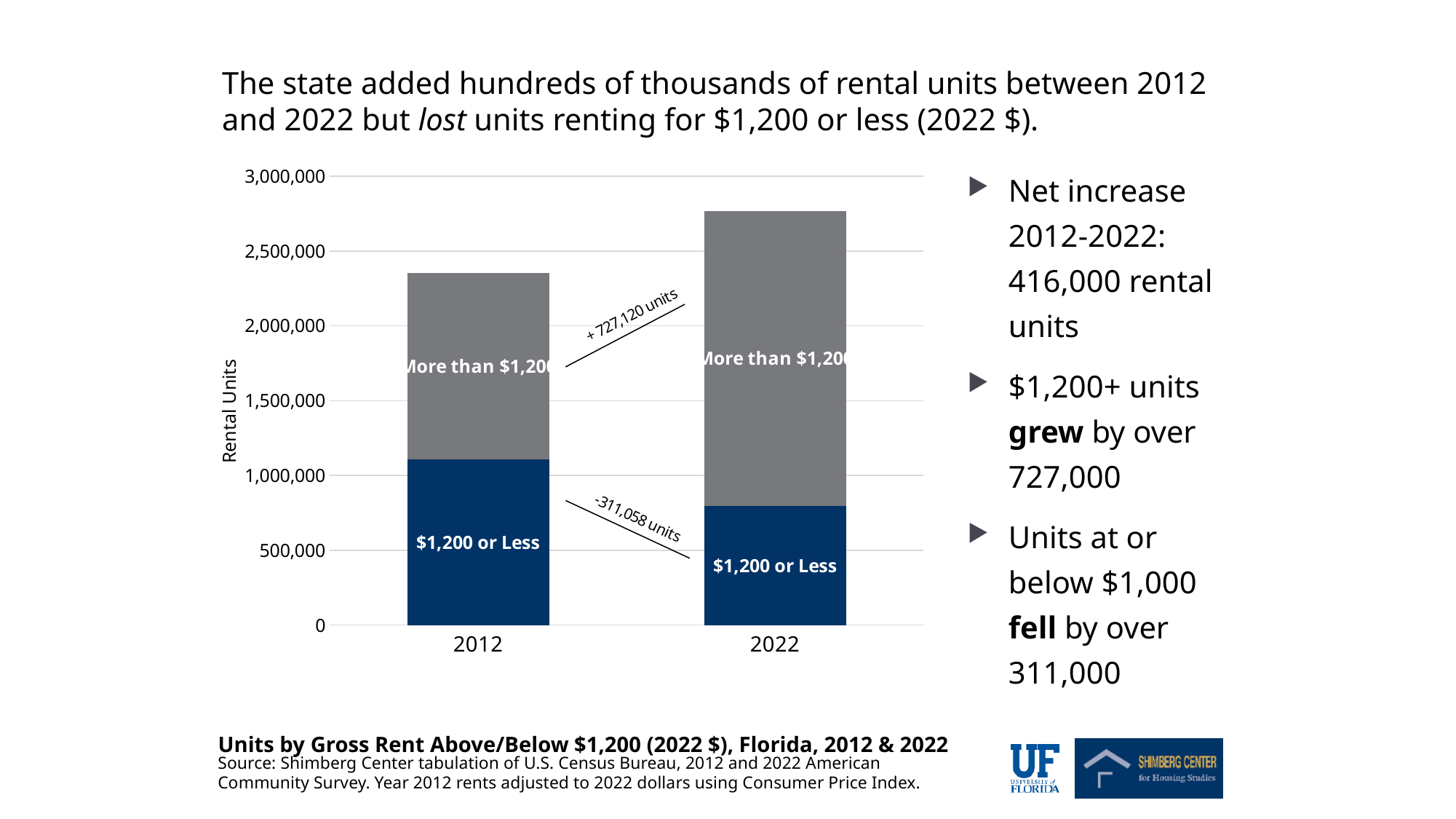
How many years (categories) are shown on the x axis of the chart? 2 Which year has more units renting for $1,200 or less, 2012 or 2022? 2012 Is the total height of the 2012 bar greater or less than 2,500,000 rental units? less How many rent segments is each bar divided into? 2 Is the '$1,200 or Less' segment for 2022 greater or less than 1,000,000 rental units? less Does the total number of rental units rise or fall from 2012 to 2022? Rise What is the label on the vertical axis of the chart? Rental Units What kind of chart is shown on the slide? Stacked bar chart According to the annotation on the chart, by how many units did the '$1,200 or Less' segment change between 2012 and 2022? -311,058 units Which year has the larger total number of rental units, 2012 or 2022? 2022 Is the total height of the 2022 bar greater or less than 2,500,000 rental units? greater According to the annotation on the chart, by how many units did the 'More than $1,200' segment change between 2012 and 2022? + 727,120 units